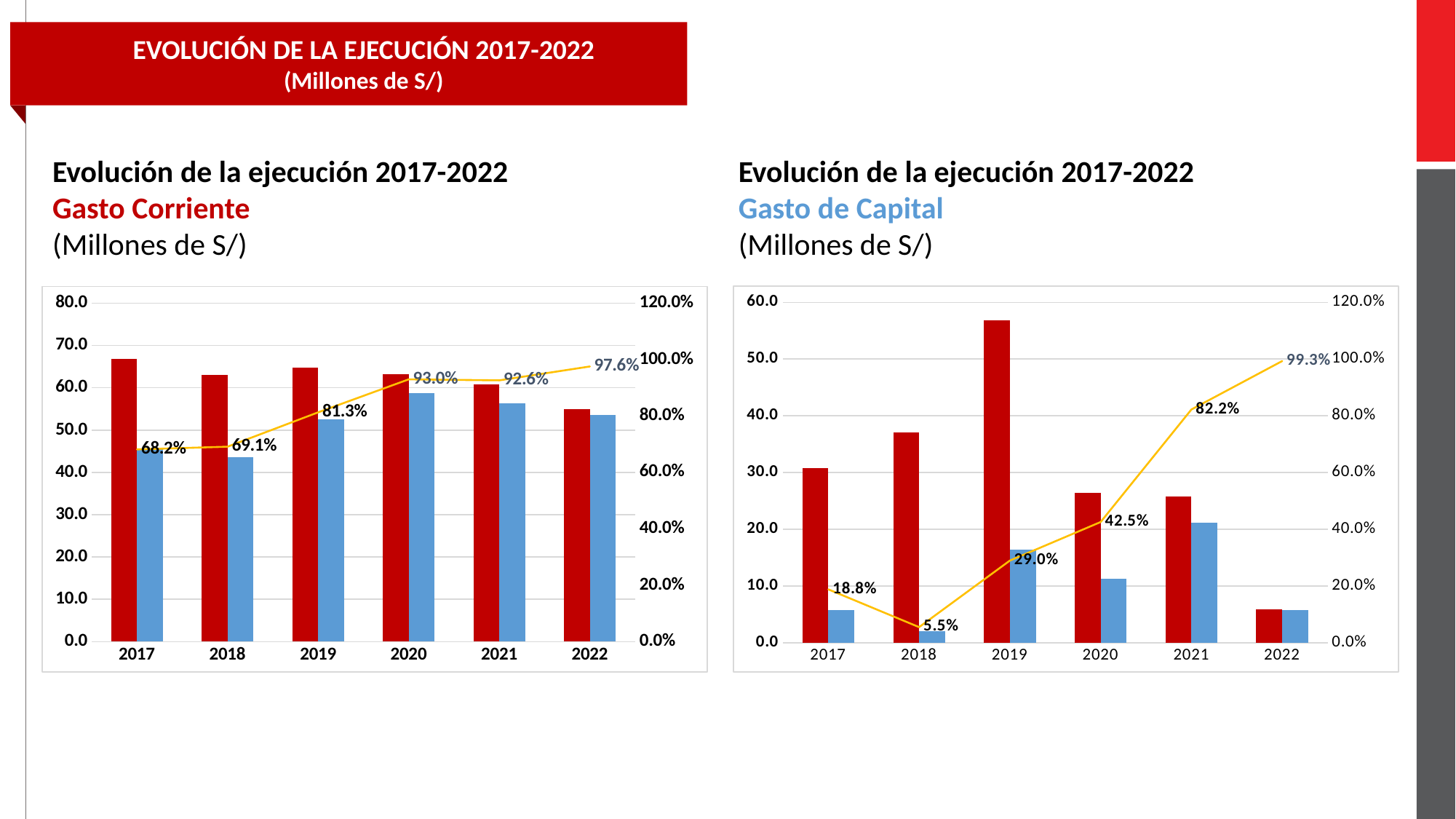
In the Gasto de Capital chart, which year has the tallest red bar? 2019 In the Gasto Corriente chart, is the red bar for 2017 greater or less than 60.0? greater In the Gasto de Capital chart, what is the difference in percentage points between the line values for 2022 and 2017? 80.5 In the Gasto Corriente chart, what percentage is shown on the line for 2019? 81.3% In the Gasto Corriente chart, which year has the shortest red bar? 2022 In the Gasto Corriente chart, which year has the highest percentage on the line? 2022 In the Gasto de Capital chart, which year has the lowest percentage on the line? 2018 How many years are shown on the x axis of the Gasto de Capital chart? 6 In the Gasto Corriente chart, which is larger, the line percentage for 2020 or for 2021? 2020 In the Gasto de Capital chart, is the red bar for 2019 greater or less than 50.0? greater In the Gasto de Capital chart, what percentage is shown on the line for 2021? 82.2% In the Gasto de Capital chart, does the line rise or fall from 2018 to 2022? rise